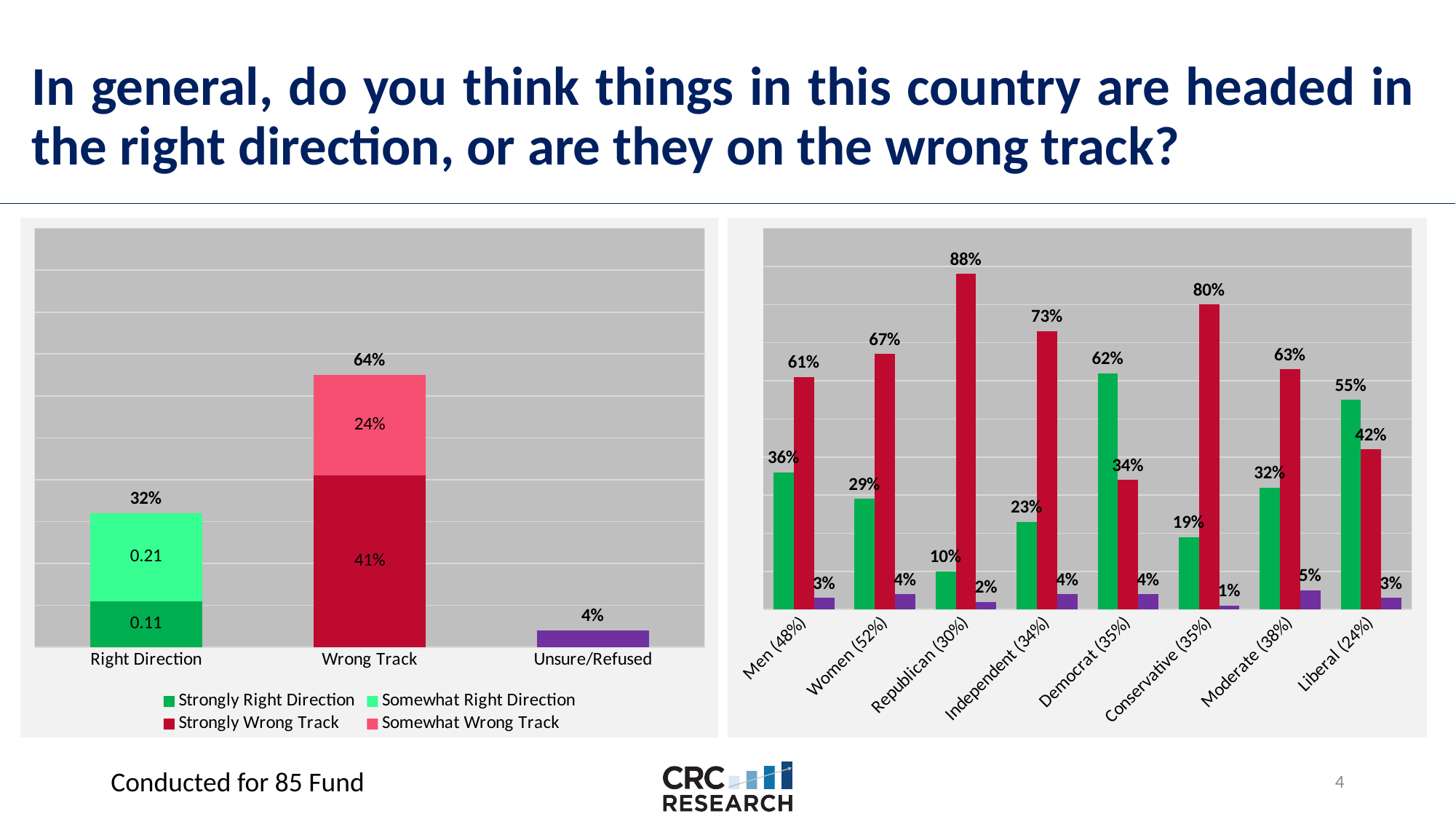
On the left chart, what is the value of the Strongly Wrong Track segment of the Wrong Track bar? 41% On the left chart, what is the total value shown for the Wrong Track bar? 64% On the right chart, what is the value of the green bar for Democrat (35%)? 62% On the right chart, which category has the lowest green bar? Republican (30%) On the left chart, how many series does the legend list? 4 On the right chart, what is the value of the red bar for Republican (30%)? 88% On the left chart, what value is printed for Unsure/Refused? 4% What kind of chart is the chart on the left? Stacked bar chart On the right chart, how many categories are shown on the x axis? 8 On the right chart, which category has the highest red bar? Republican (30%) On the right chart, is the green bar for Liberal (24%) larger or smaller than the red bar for Liberal (24%)? Larger On the left chart, what is the difference between the Wrong Track total and the Right Direction total? 32%